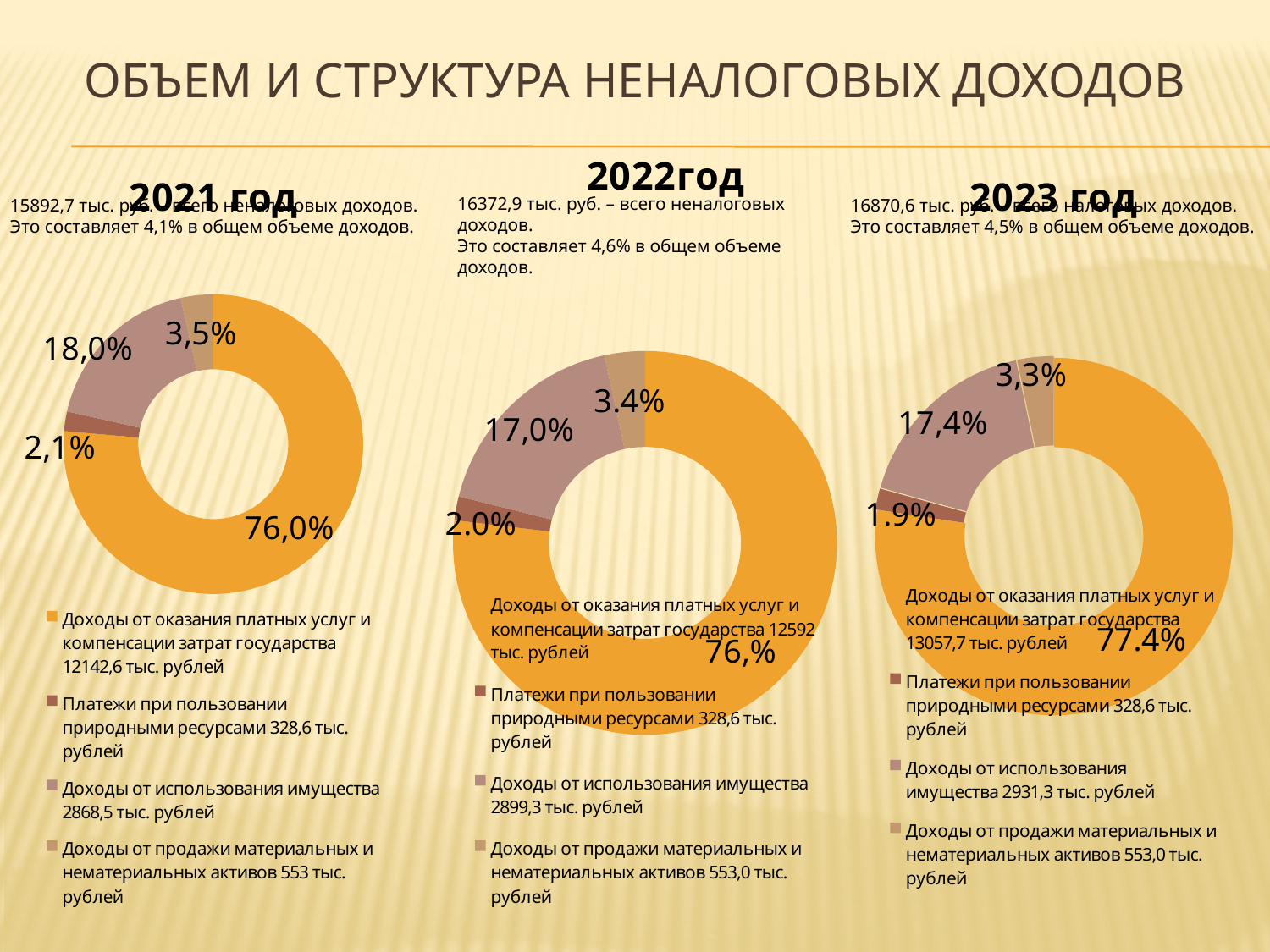
In the 2022год chart, what share is shown for Доходы от продажи материальных и нематериальных активов? 3.4% In the 2022год chart, what share is shown for Платежи при пользовании природными ресурсами? 2.0% In the 2021 год chart, what share is shown for Доходы от оказания платных услуг и компенсации затрат государства? 76,0% How many slices does the 2022год chart have? 4 How many entries does the legend of the 2023 год chart list? 4 In the 2023 год chart, what share is shown for Доходы от оказания платных услуг и компенсации затрат государства? 77.4% In the 2021 год chart, what share is shown for Доходы от использования имущества? 18,0% In the 2021 год chart, which category has the smallest share? Платежи при пользовании природными ресурсами What kind of chart is used for the 2021 год data? Doughnut (pie) chart In the 2023 год chart, which category has the largest share? Доходы от оказания платных услуг и компенсации затрат государства In the 2023 год chart, which is larger: the share for Доходы от использования имущества or the share for Доходы от продажи материальных и нематериальных активов? Доходы от использования имущества In the 2021 год chart, what is the difference between the 18,0% slice and the 3,5% slice? 14,5%